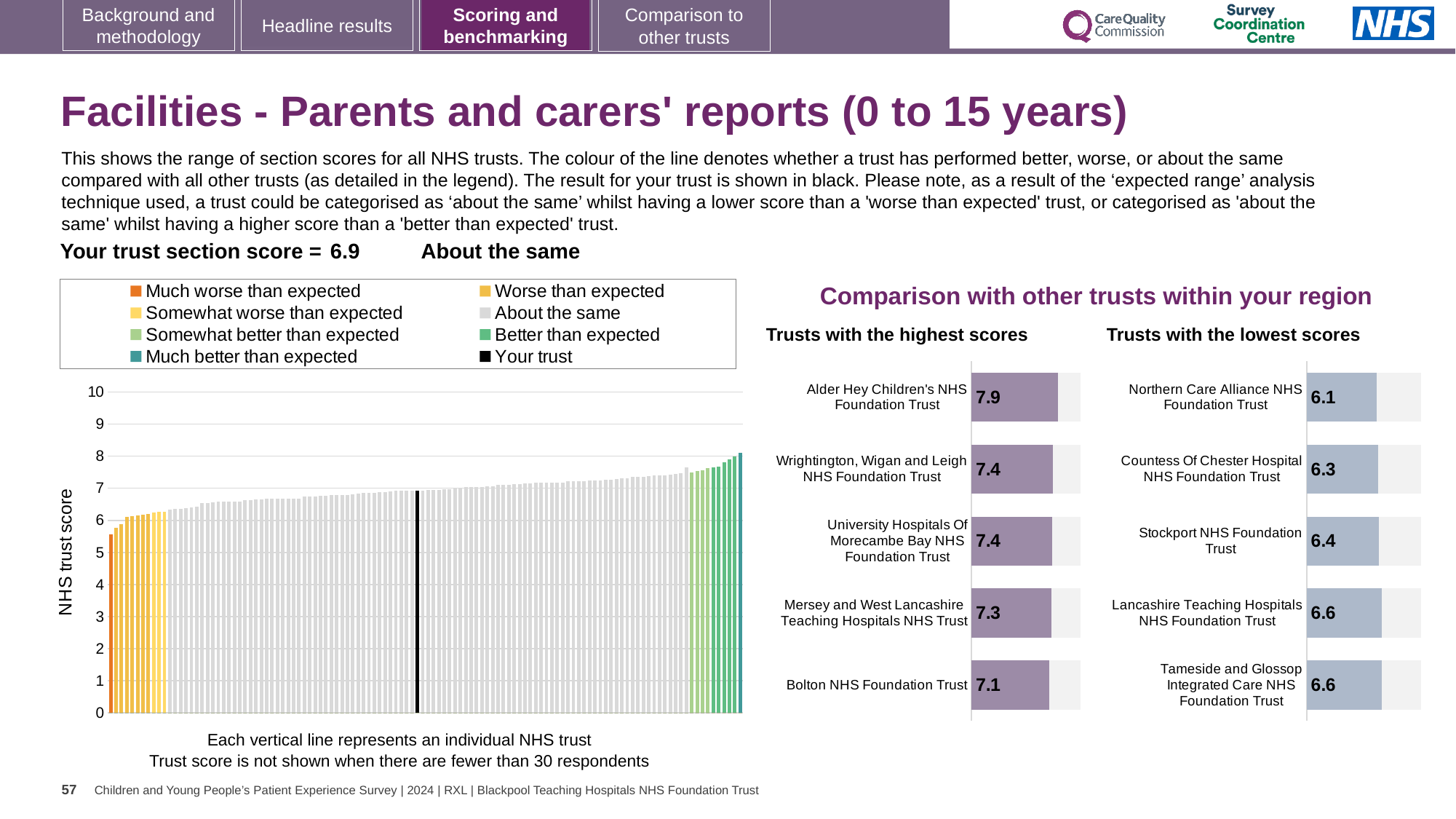
In the 'Trusts with the lowest scores' chart, which trust has the lowest score? Northern Care Alliance NHS Foundation Trust In the main chart on the left, is the lowest trust score greater or less than 6? less In the 'Trusts with the lowest scores' chart, which has the larger score: Countess Of Chester Hospital NHS Foundation Trust or Stockport NHS Foundation Trust? Stockport NHS Foundation Trust In the 'Trusts with the highest scores' chart, which trust has the highest score? Alder Hey Children's NHS Foundation Trust In the 'Trusts with the highest scores' chart, what is the score for Bolton NHS Foundation Trust? 7.1 In the 'Trusts with the lowest scores' chart, what is the score for Countess Of Chester Hospital NHS Foundation Trust? 6.3 How many trusts are shown in the 'Trusts with the lowest scores' chart? 5 In the 'Trusts with the highest scores' chart, what is the score for Alder Hey Children's NHS Foundation Trust? 7.9 What kind of chart is the main chart on the left showing all NHS trusts? Bar chart In the 'Trusts with the highest scores' chart, what is the difference between the scores of Alder Hey Children's NHS Foundation Trust and Bolton NHS Foundation Trust? 0.8 What is the y-axis label of the main chart on the left? NHS trust score How many entries does the legend of the main chart on the left list? 8